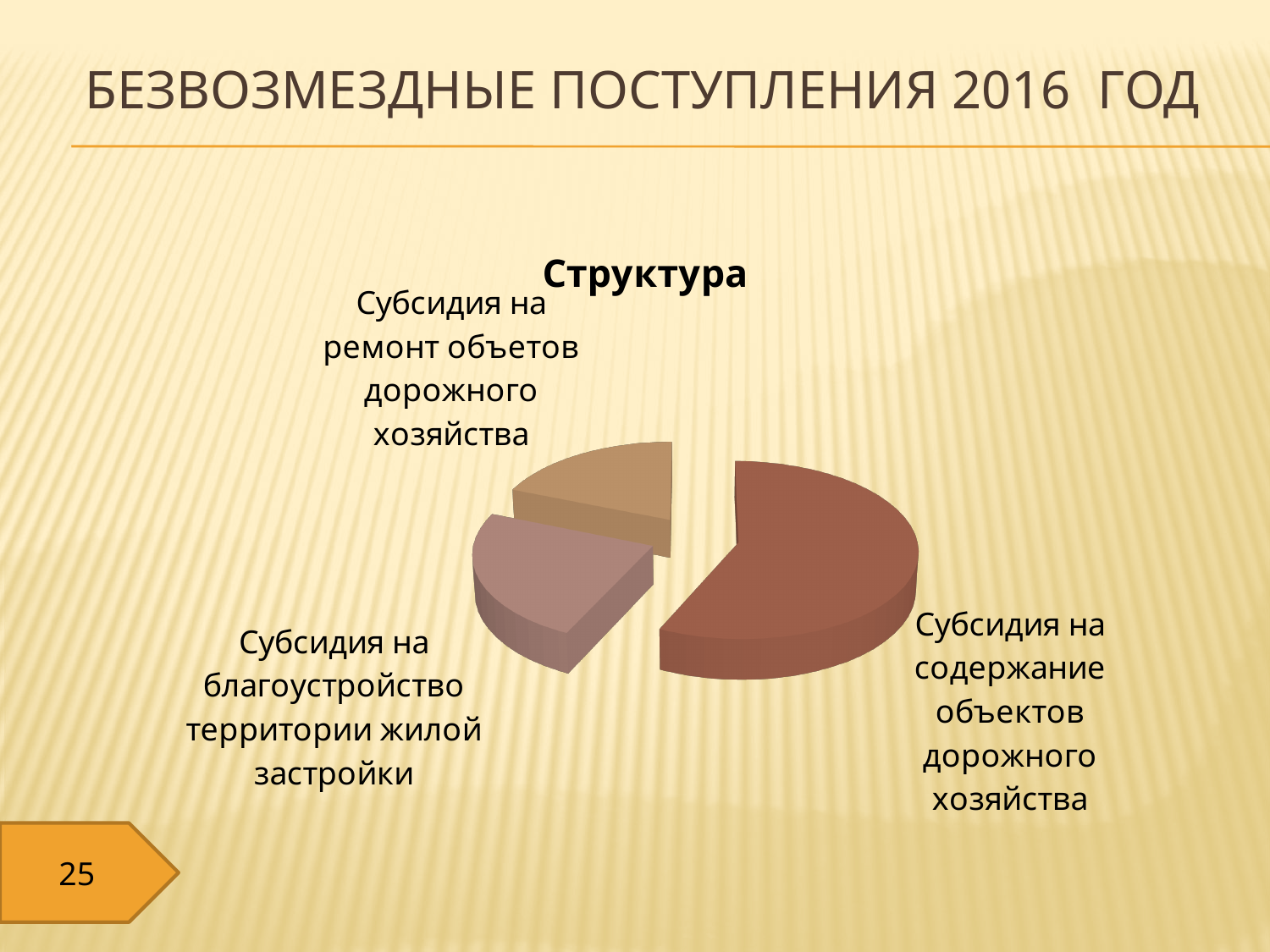
What kind of chart is shown on the slide? Pie chart Does the slice for 'Субсидия на содержание объектов дорожного хозяйства' take up more or less than half of the pie? more Which is larger: the slice for 'Субсидия на содержание объектов дорожного хозяйства' or the slice for 'Субсидия на благоустройство территории жилой застройки'? Субсидия на содержание объектов дорожного хозяйства What is the title of the slide containing the chart? БЕЗВОЗМЕЗДНЫЕ ПОСТУПЛЕНИЯ 2016 ГОД How many slices does the pie chart have? 3 Which category has the largest slice of the pie? Субсидия на содержание объектов дорожного хозяйства What is the title of the chart? Структура Which is larger: the slice for 'Субсидия на ремонт объетов дорожного хозяйства' or the slice for 'Субсидия на содержание объектов дорожного хозяйства'? Субсидия на содержание объектов дорожного хозяйства